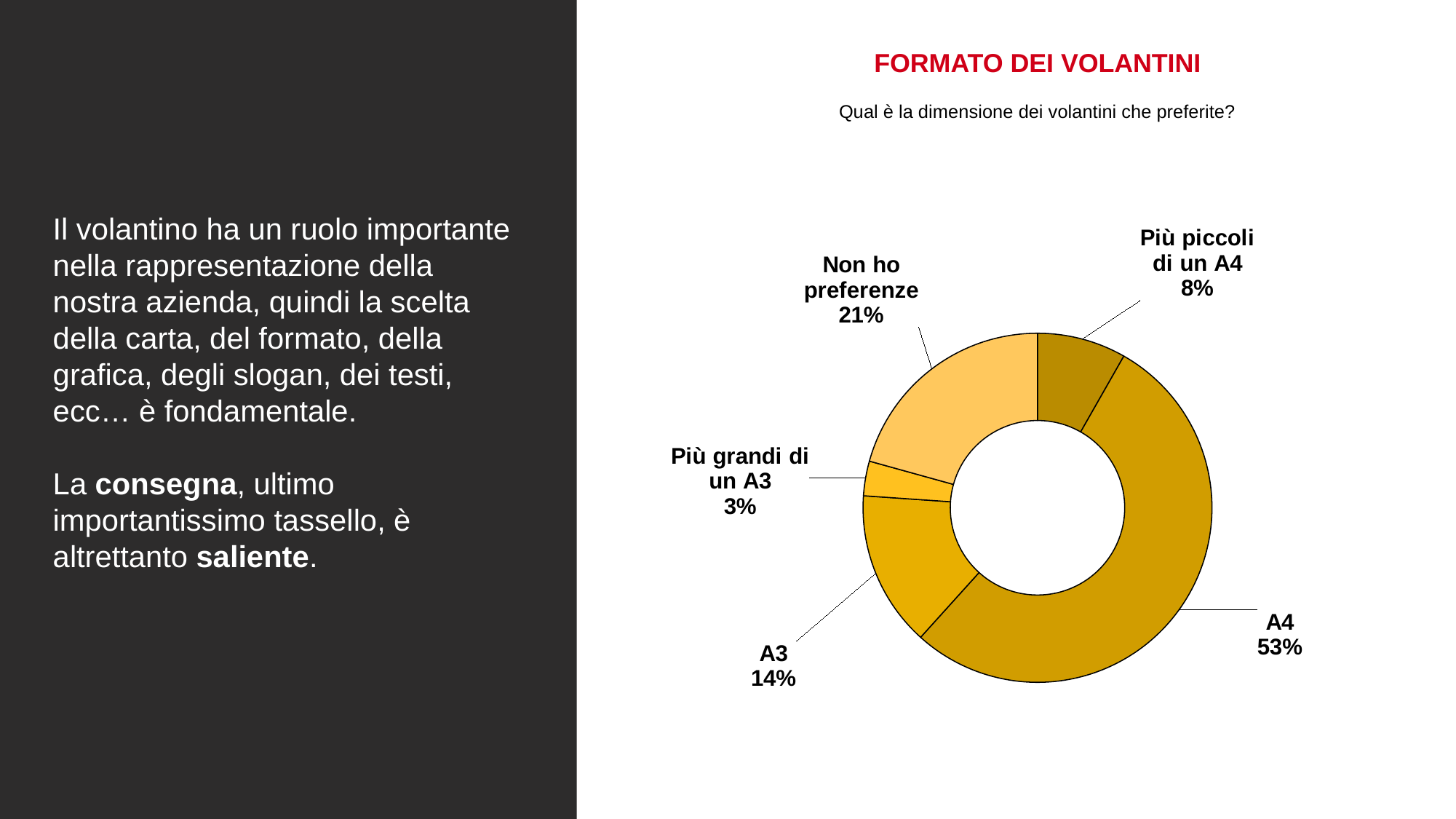
Which is larger: 'Non ho preferenze' or 'A3'? Non ho preferenze Which category has the smallest share? Più grandi di un A3 What percentage of respondents chose 'Non ho preferenze'? 21% What is the value for 'Più grandi di un A3'? 3% What is the title of the chart? FORMATO DEI VOLANTINI What share of respondents prefer A4? 53% What question does the chart subtitle ask? Qual è la dimensione dei volantini che preferite? What is the value for 'Più piccoli di un A4'? 8% What is the difference in percentage points between A4 and A3? 39 What kind of chart is shown on the slide? Doughnut chart Which category has the largest share? A4 How many categories are shown in the chart? 5